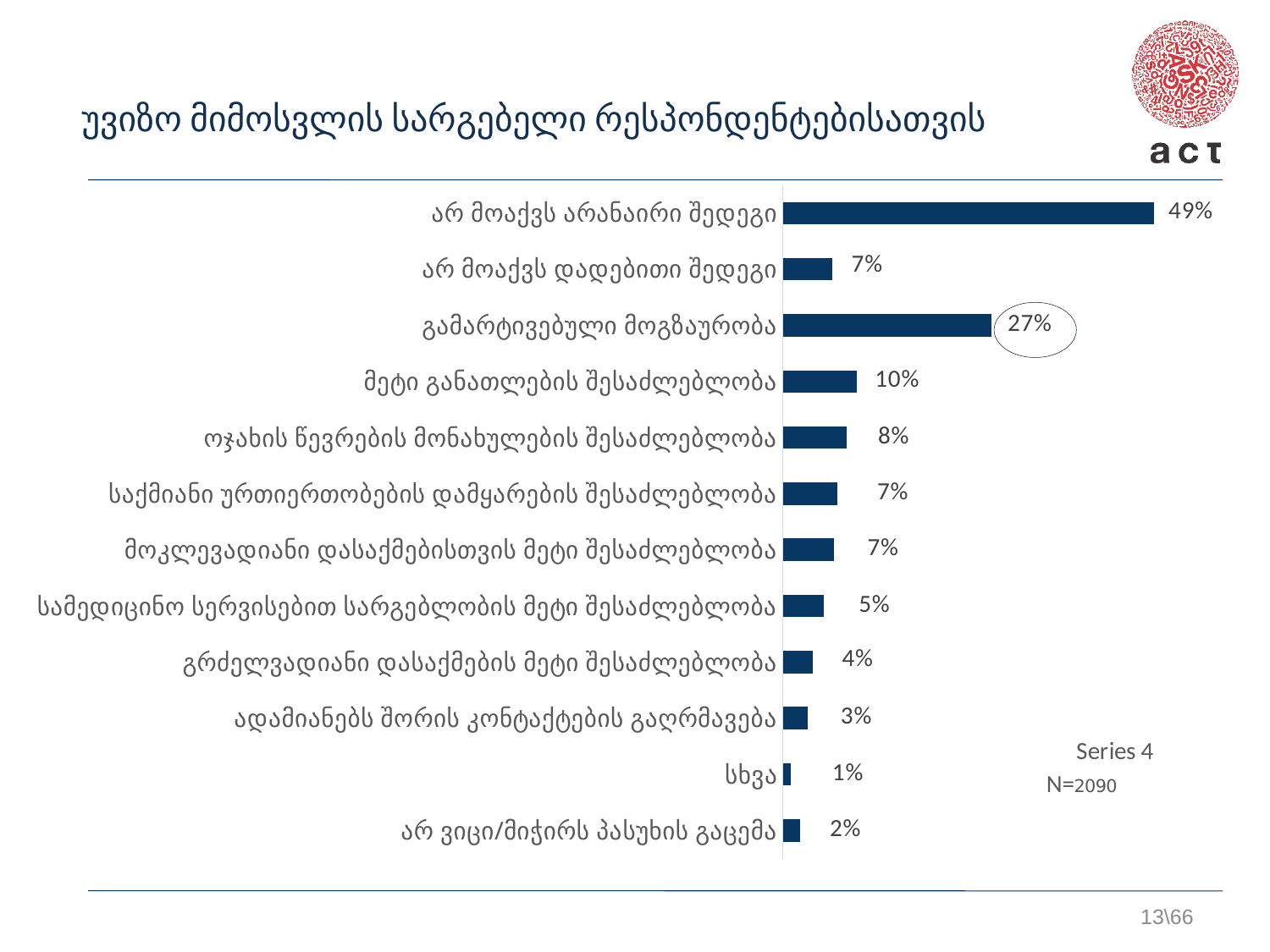
What value is shown for "არ მოაქვს არანაირი შედეგი"? 49% How many categories are shown in the chart? 12 Which category has the lowest value? სხვა Which data label on the chart is circled? 27% What is the difference between the values for "არ მოაქვს არანაირი შედეგი" and "გამარტივებული მოგზაურობა"? 22% What value is shown for "სხვა"? 1% What is the sample size (N) shown on the slide? N=2090 What value is shown for "გამარტივებული მოგზაურობა"? 27% Which category has the highest value? არ მოაქვს არანაირი შედეგი Which is larger: the value for "ოჯახის წევრების მონახულების შესაძლებლობა" or for "სამედიცინო სერვისებით სარგებლობის მეტი შესაძლებლობა"? ოჯახის წევრების მონახულების შესაძლებლობა What value is shown for "მეტი განათლების შესაძლებლობა"? 10% What kind of chart is shown on the slide? Bar chart